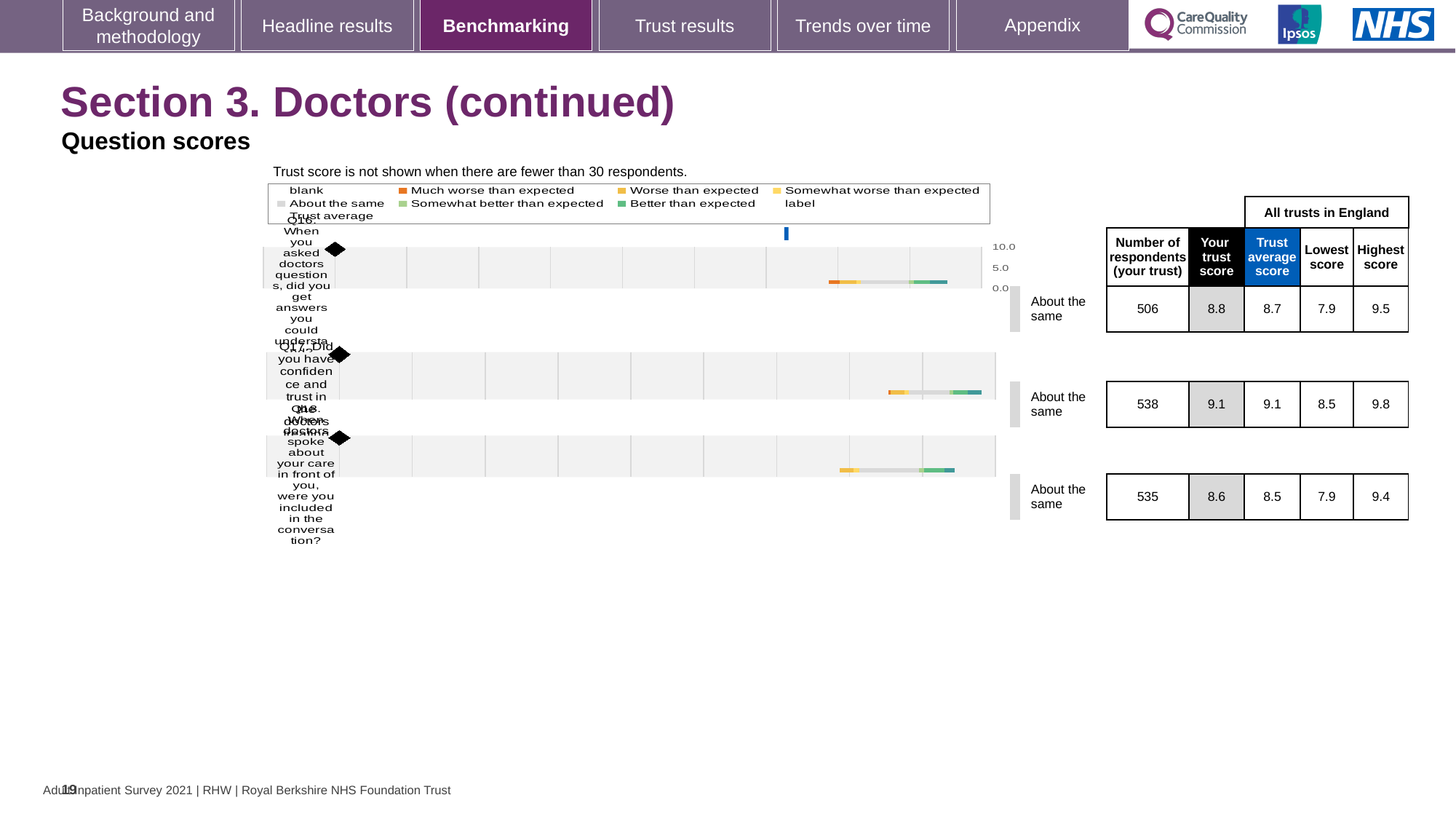
For Q16, which is larger: your trust score or the trust average score? Your trust score Which question has the highest 'Your trust score'? Q17 What is the difference between your trust score and the lowest score for Q16? 0.9 Is the trust score for Q17 greater or less than 5.0? greater Which question has the lowest 'Your trust score'? Q18 How many questions are plotted on the chart? 3 How many respondents from your trust answered Q17 (Did you have confidence and trust in the doctors)? 538 What is the difference between the highest score and the lowest score for Q17? 1.3 What is the 'Your trust score' value for Q16 (When you asked doctors questions, did you get answers you could understand)? 8.8 What is the trust average score for Q18 (When doctors spoke about your care in front of you, were you included in the conversation)? 8.5 What is the highest score across all trusts in England for Q16? 9.5 What kind of chart is used to show the question scores? Bar chart